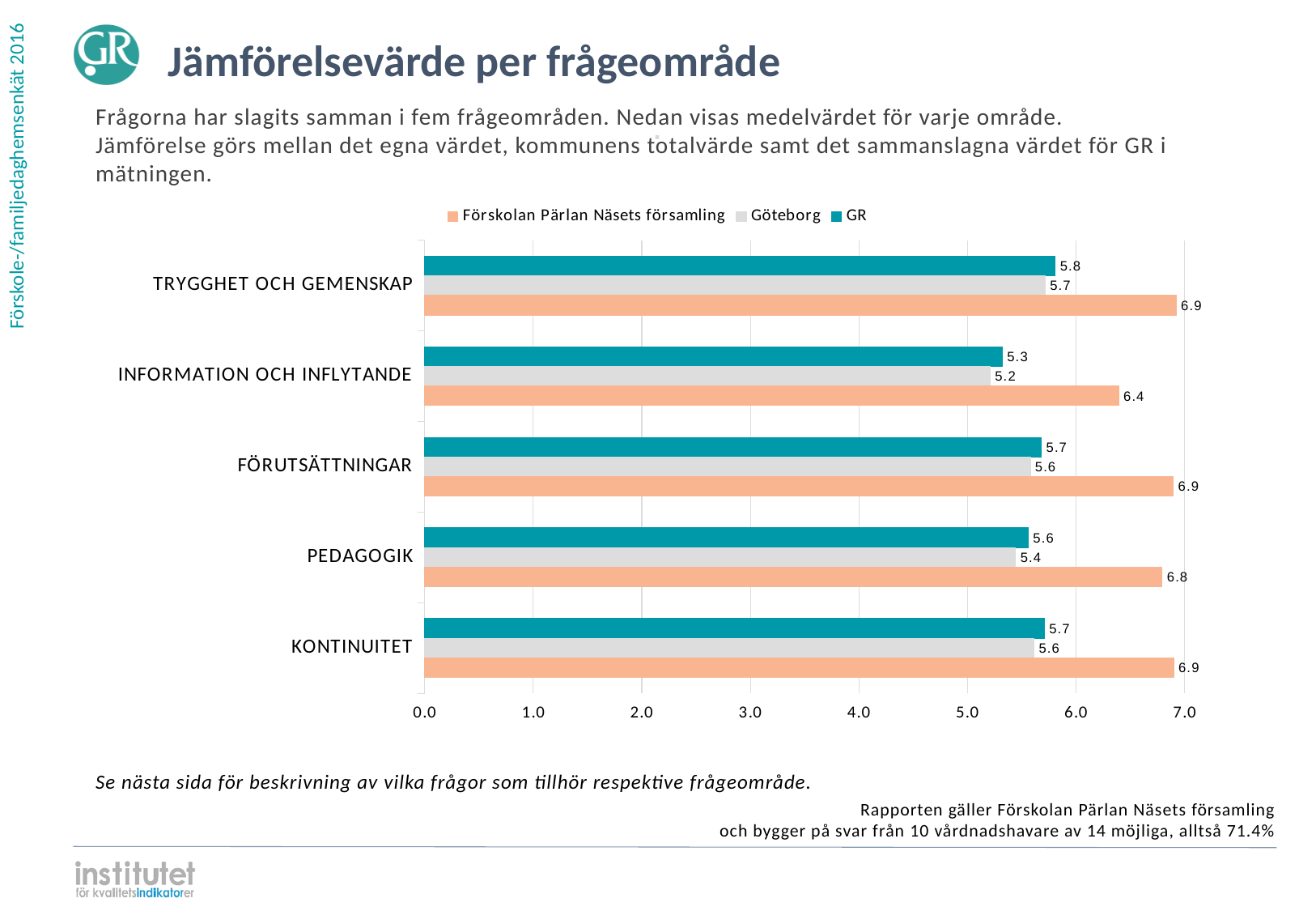
What is the GR value for PEDAGOGIK? 5.6 What is the Göteborg value for INFORMATION OCH INFLYTANDE? 5.2 What kind of chart is shown on the slide? Bar chart Which category has the highest GR value? TRYGGHET OCH GEMENSKAP Which category has the lowest value for Förskolan Pärlan Näsets församling? INFORMATION OCH INFLYTANDE Which is larger for KONTINUITET: the GR value or the Göteborg value? GR Which series is shown in orange in the legend? Förskolan Pärlan Näsets församling What is the title of the chart on the slide? Jämförelsevärde per frågeområde How many series does the legend list? 3 What is the value for Förskolan Pärlan Näsets församling in the TRYGGHET OCH GEMENSKAP category? 6.9 What is the difference between the Förskolan Pärlan Näsets församling value and the Göteborg value for PEDAGOGIK? 1.4 How many categories are shown on the chart? 5